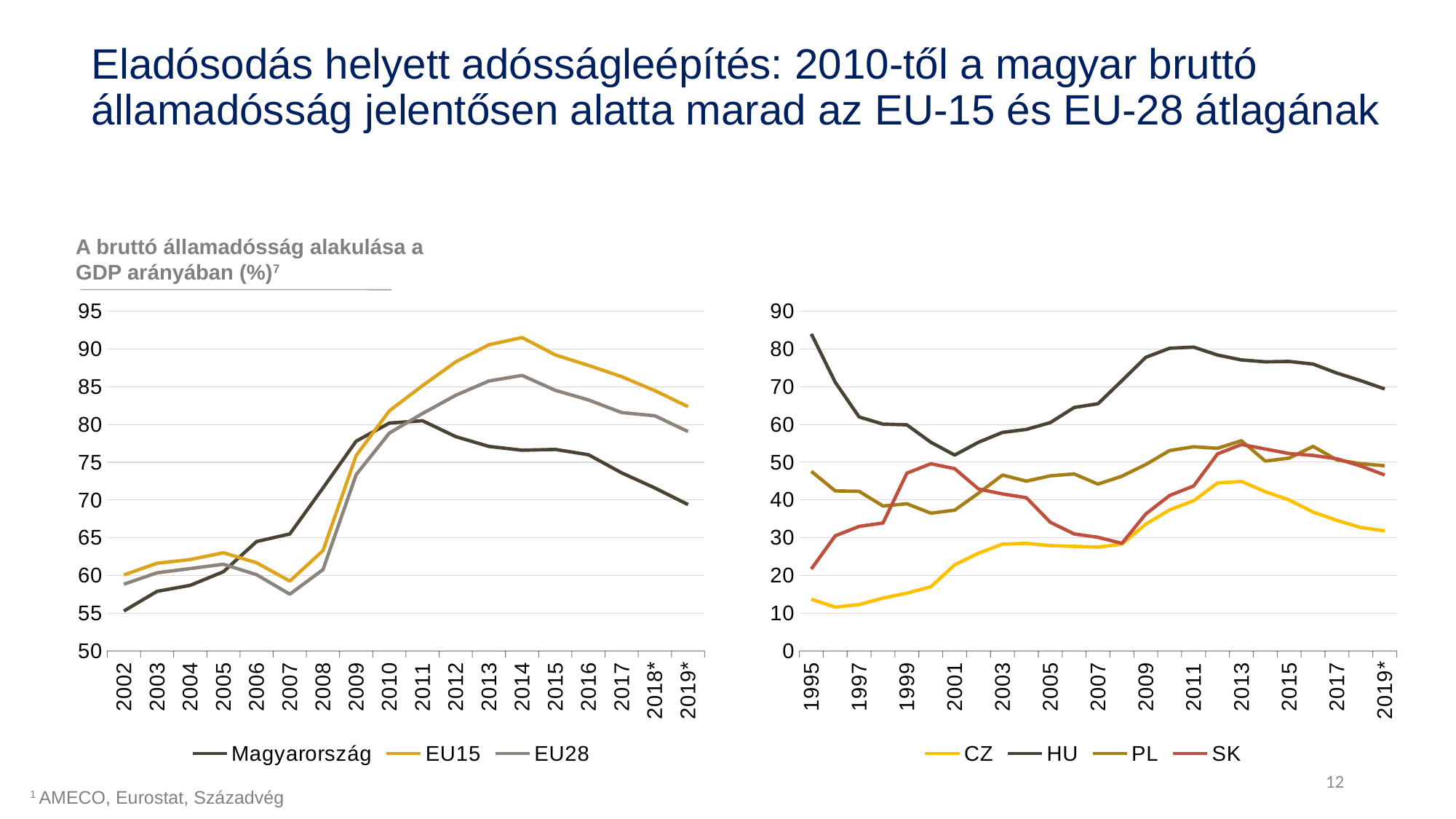
In the left chart, is the value for Magyarország in 2002 greater or less than 60? less In the left chart, which series has the lowest value in 2002? Magyarország In the right chart, which series has the lowest value in 2019*? CZ In the left chart, is the value for EU15 in 2014 greater or less than 90? greater In the left chart, does the Magyarország line rise or fall from 2011 to 2019*? fall In the right chart, is the value for HU in 1995 greater or less than 80? greater How many series does the legend of the right chart list? 4 How many series does the legend of the left chart list? 3 In the right chart, which is larger in 1995, HU or CZ? HU In the left chart, how many years are shown on the x axis? 18 What kind of chart is the left chart titled 'A bruttó államadósság alakulása a GDP arányában (%)'? line chart In the left chart, which series has the highest value in 2014? EU15